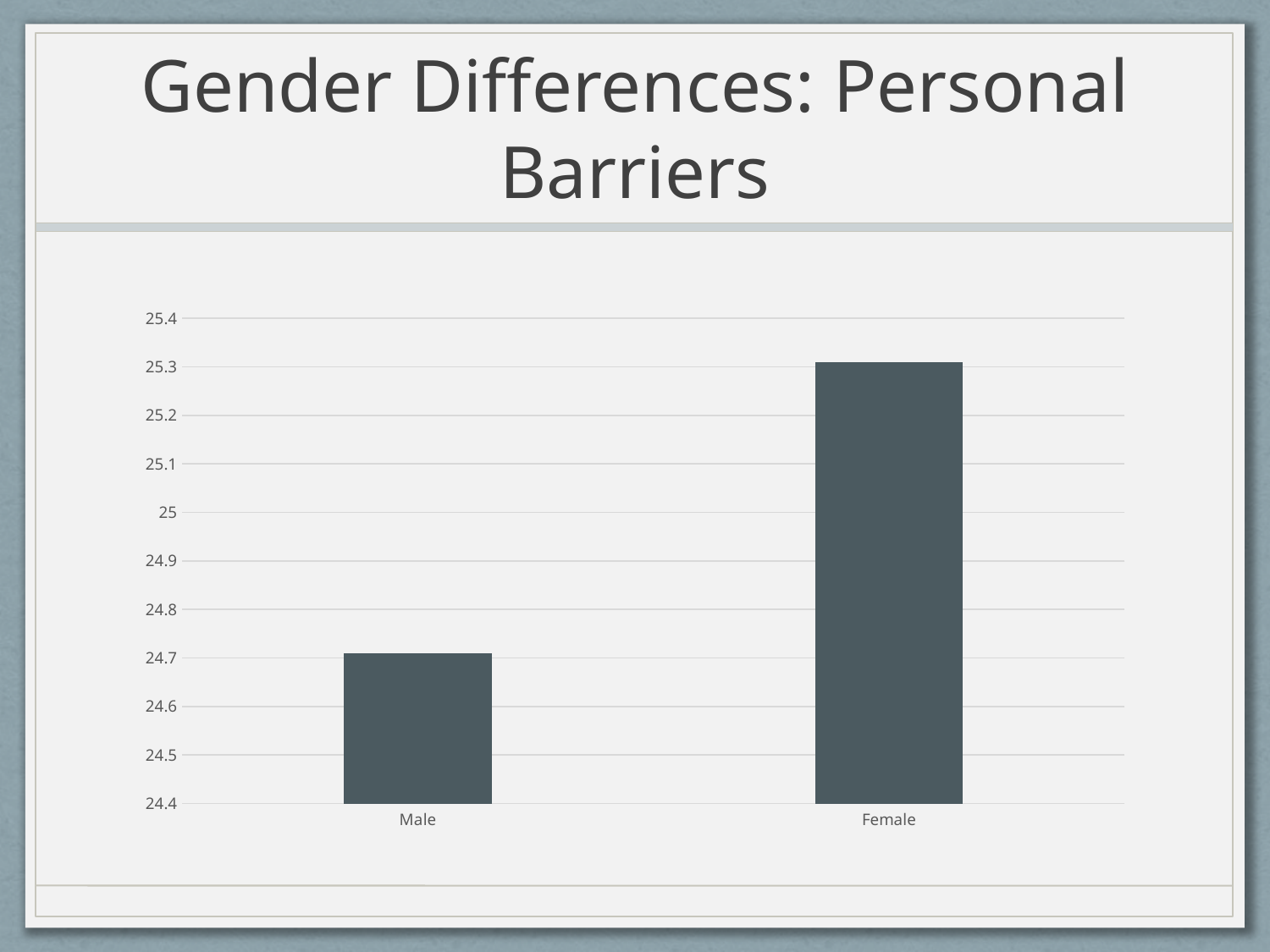
What kind of chart is shown on the slide? bar chart Is the value for Female greater or less than 25.2? greater What is the title of the slide containing the chart? Gender Differences: Personal Barriers Is the value for Female greater or less than 25.4? less What is the lowest value shown on the vertical axis of the chart? 24.4 Is the value for Male greater or less than 25? less Which category has the highest value on the chart? Female How many categories are plotted on the chart? 2 Which category has the lowest value on the chart? Male Which is larger, the value for Male or the value for Female? Female